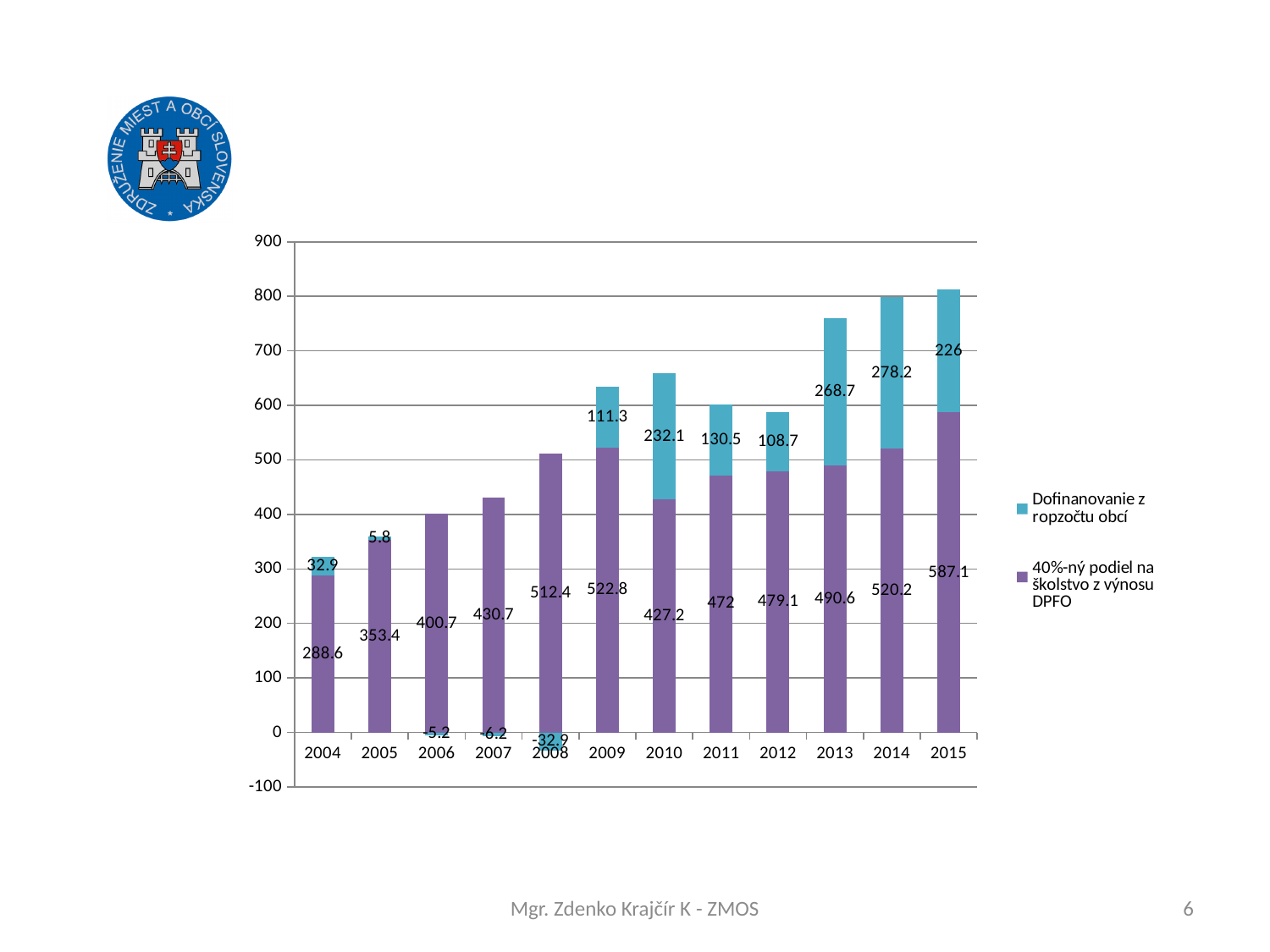
What is the value of the 'Dofinanovanie z ropzočtu obcí' series for 2010? 232.1 What is the value of the '40%-ný podiel na školstvo z výnosu DPFO' series for 2015? 587.1 Does the '40%-ný podiel na školstvo z výnosu DPFO' value rise or fall from 2004 to 2009? Rise How many years are shown on the x axis of the chart? 12 What is the total height of the stacked bar for 2015? 813.1 What kind of chart is shown on the slide? Stacked bar chart What is the difference between the '40%-ný podiel na školstvo z výnosu DPFO' values for 2015 and 2004? 298.5 What is the value of the 'Dofinanovanie z ropzočtu obcí' series for 2007? -6.2 How many series does the legend list? 2 In which year is the '40%-ný podiel na školstvo z výnosu DPFO' value the lowest? 2004 In which year is the '40%-ný podiel na školstvo z výnosu DPFO' value the highest? 2015 Which year has the larger 'Dofinanovanie z ropzočtu obcí' value, 2010 or 2011? 2010